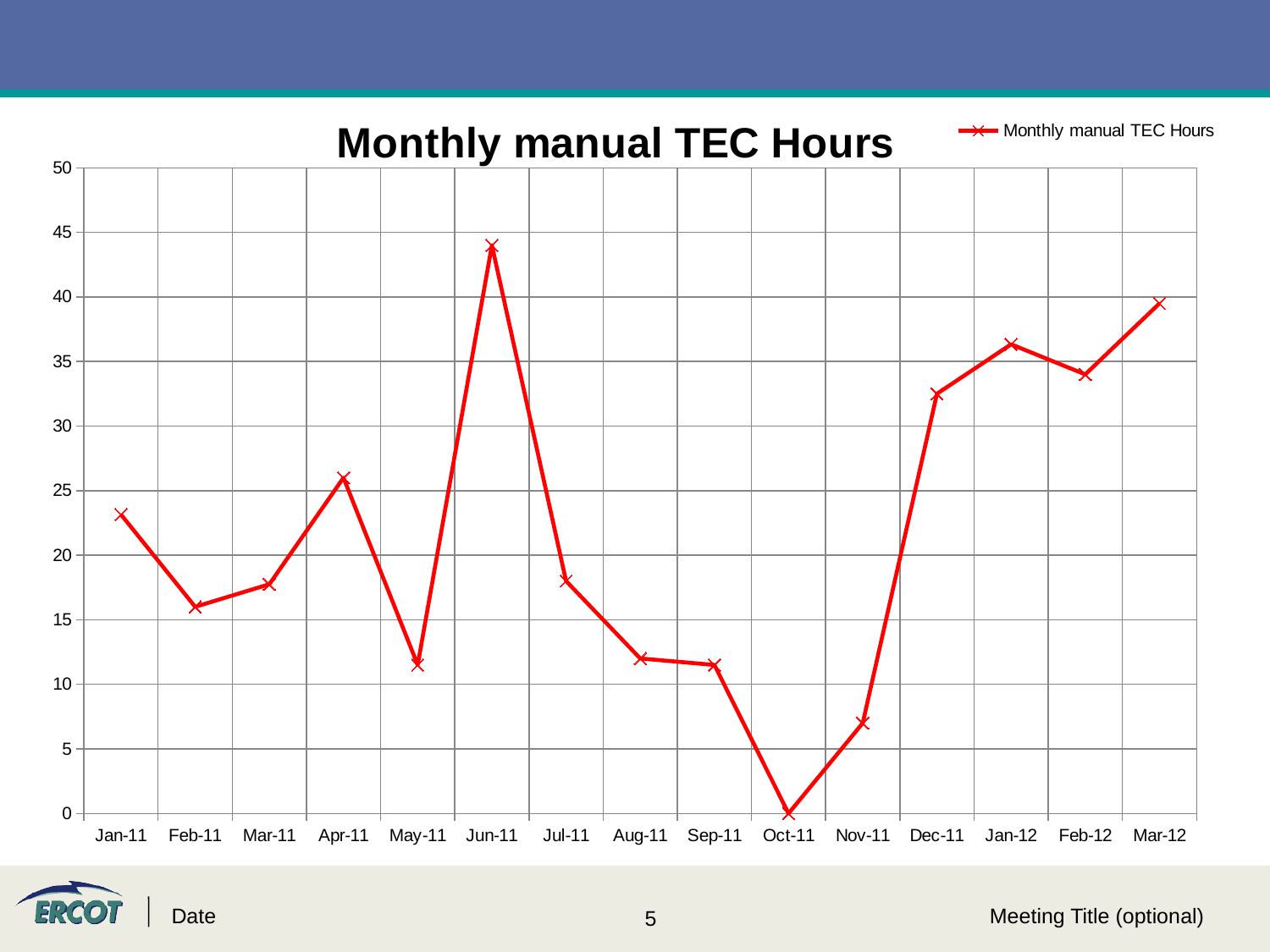
Is the value for Jun-11 greater or less than 40? greater How many series does the legend list? 1 What is the title of the chart? Monthly manual TEC Hours How many months are plotted along the x axis? 15 Which is larger, the value for Jun-11 or the value for Apr-11? Jun-11 What kind of chart is shown on the slide? line chart What is the value for Oct-11? 0 Which month has the highest value for Monthly manual TEC Hours? Jun-11 Do the values rise or fall from Jun-11 to Oct-11? fall Is the value for Dec-11 greater or less than 30? greater Which month has the lowest value for Monthly manual TEC Hours? Oct-11 Is the value for Nov-11 greater or less than 10? less